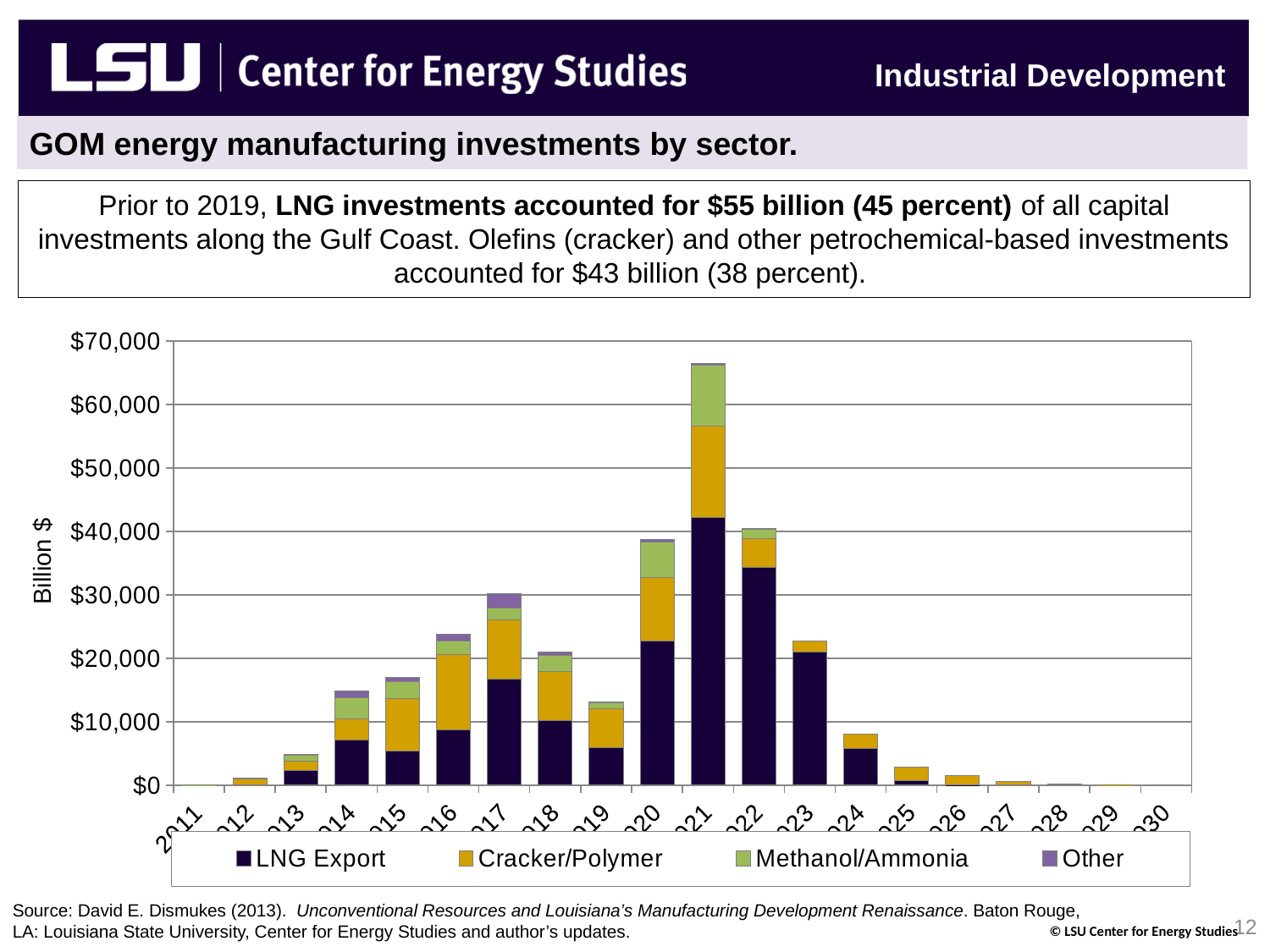
Do the total investments rise or fall from 2021 to 2030? fall Is the LNG Export value for 2022 greater or less than $30,000? greater What kind of chart is shown on the slide? Stacked bar chart Which year has the larger total investment, 2020 or 2023? 2020 Which year has the highest total investment in the chart? 2021 How many series does the chart legend list? 4 Which year has the larger total investment, 2018 or 2019? 2018 What is the label on the y axis of the chart? Billion $ Is the total investment for 2021 greater or less than $60,000? greater Is the total investment for 2020 greater or less than $30,000? greater How many years are shown along the x axis of the chart? 20